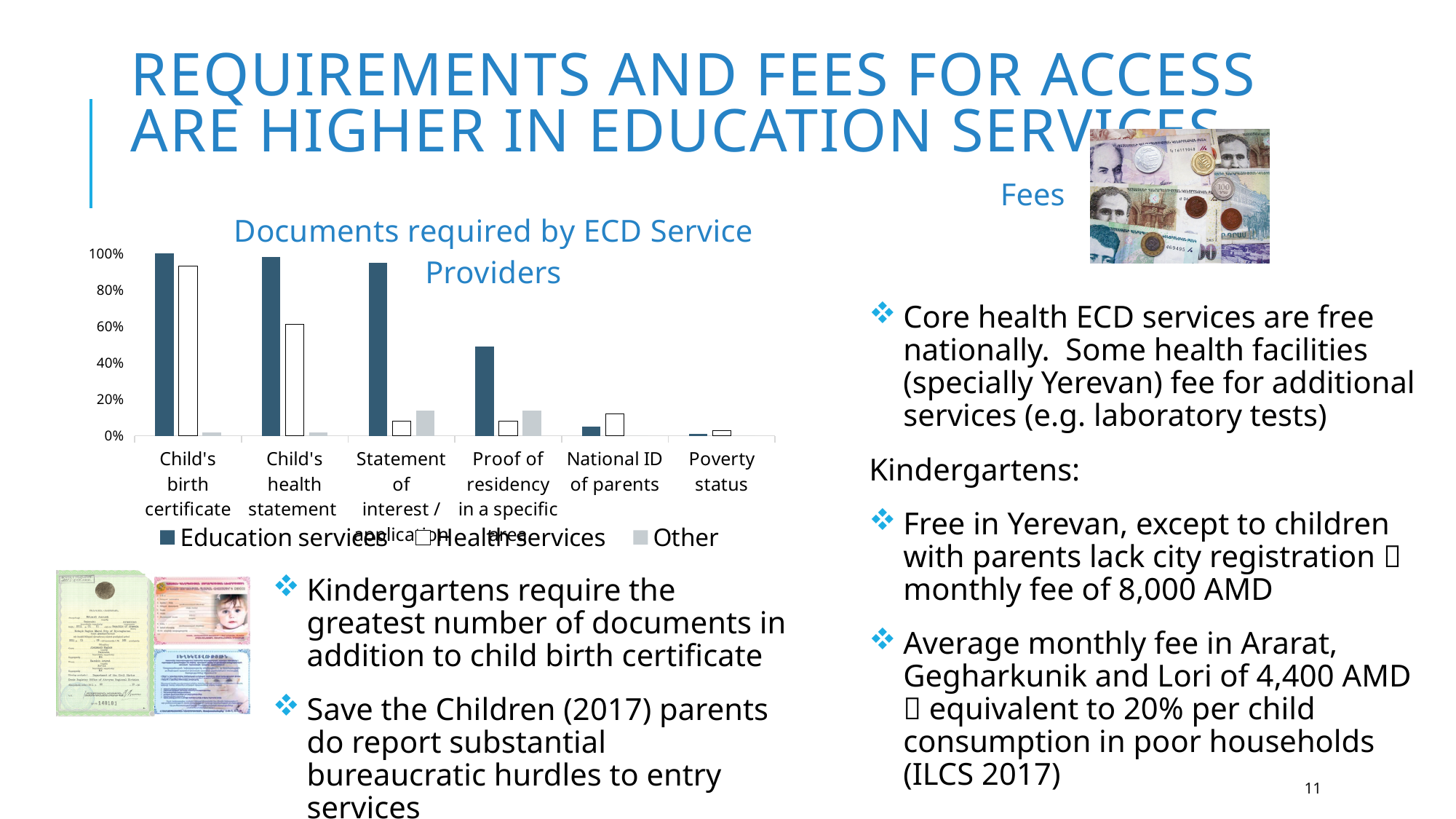
In the 'Documents required by ECD Service Providers' chart, which category has the lowest value for Education services? Poverty status In the 'Documents required by ECD Service Providers' chart, is the Health services value for 'Child's birth certificate' greater or less than 80%? greater Which series in the 'Documents required by ECD Service Providers' chart is shown with dark blue bars? Education services How many series does the legend of the 'Documents required by ECD Service Providers' chart list? 3 How many document categories are shown on the x axis of the 'Documents required by ECD Service Providers' chart? 6 In the 'Documents required by ECD Service Providers' chart, is the Health services value for 'Child's health statement' greater or less than 40%? greater What kind of chart is 'Documents required by ECD Service Providers'? Bar chart In the 'Documents required by ECD Service Providers' chart, which is larger for 'Statement of interest / application': Education services or Health services? Education services In the 'Documents required by ECD Service Providers' chart, is the Education services value for 'Proof of residency in a specific area' greater or less than 60%? less In the 'Documents required by ECD Service Providers' chart, which is larger for 'National ID of parents': Education services or Health services? Health services What is the title of the chart on the slide? Documents required by ECD Service Providers In the 'Documents required by ECD Service Providers' chart, do the Education services values rise or fall moving from left to right along the x axis? fall